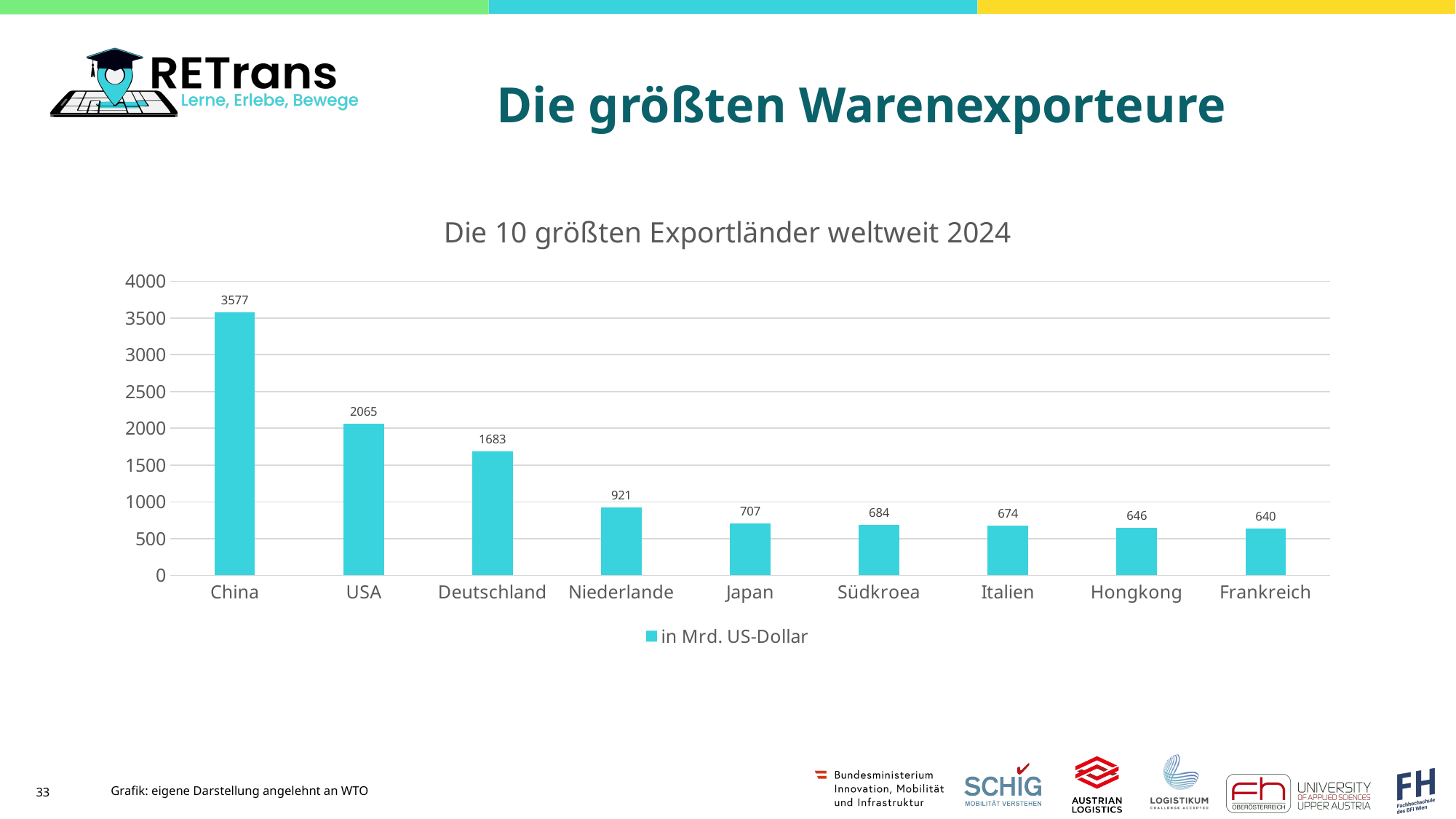
What is the value for Hongkong? 646 What kind of chart is shown? bar chart What is the value for China? 3577 How many countries are shown on the x axis? 9 Which country has the highest value? China Which is larger, the value for Südkroea or the value for Italien? Südkroea What is the difference between the values for Niederlande and Japan? 214 What is the title of the chart? Die 10 größten Exportländer weltweit 2024 What is the value for Deutschland? 1683 How many series does the legend list? 1 What is the difference between the values for China and USA? 1512 Which country has the lowest value? Frankreich